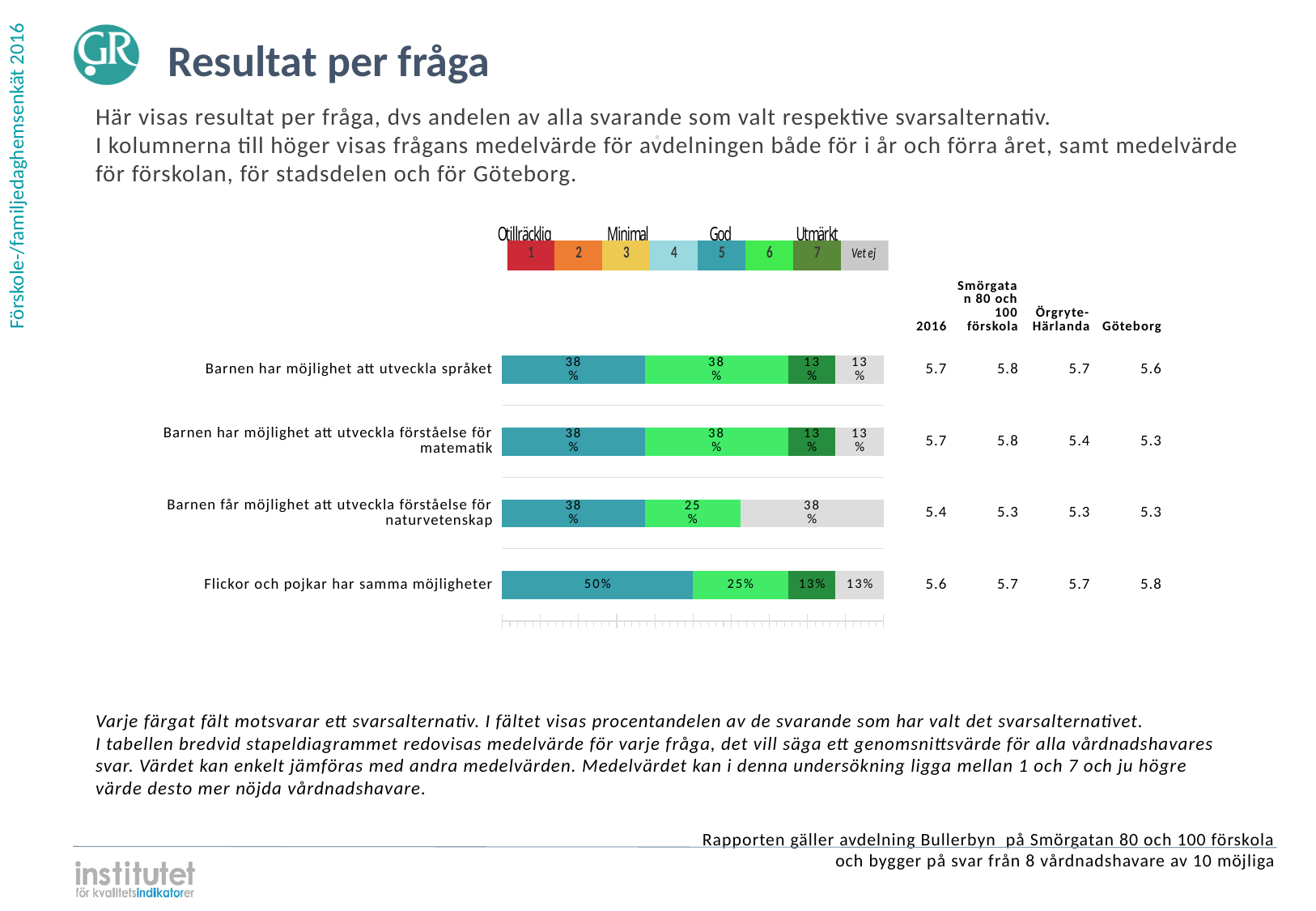
What percentage chose alternative 6 (light green) for 'Barnen har möjlighet att utveckla språket'? 38% What is the difference in percentage points between the alternative 5 share for 'Flickor och pojkar har samma möjligheter' and for 'Barnen har möjlighet att utveckla språket'? 12 percentage points Which response alternative is shown in red in the legend? 1 What percentage of respondents chose alternative 5 (teal) for 'Flickor och pojkar har samma möjligheter'? 50% What kind of chart is used to show the results per question on this slide? Stacked bar chart Which question has the largest share of respondents choosing alternative 5 (teal)? Flickor och pojkar har samma möjligheter What is the Göteborg mean value shown for 'Flickor och pojkar har samma möjligheter'? 5.8 How many response alternatives does the legend above the chart list? 8 What percentage chose 'Vet ej' for 'Barnen får möjlighet att utveckla förståelse för naturvetenskap'? 38% How many questions (categories) are shown in the bar chart? 4 What is the 2016 mean value shown for 'Barnen får möjlighet att utveckla förståelse för naturvetenskap'? 5.4 Which is larger: the alternative 6 share for 'Barnen har möjlighet att utveckla förståelse för matematik' or for 'Flickor och pojkar har samma möjligheter'? Barnen har möjlighet att utveckla förståelse för matematik